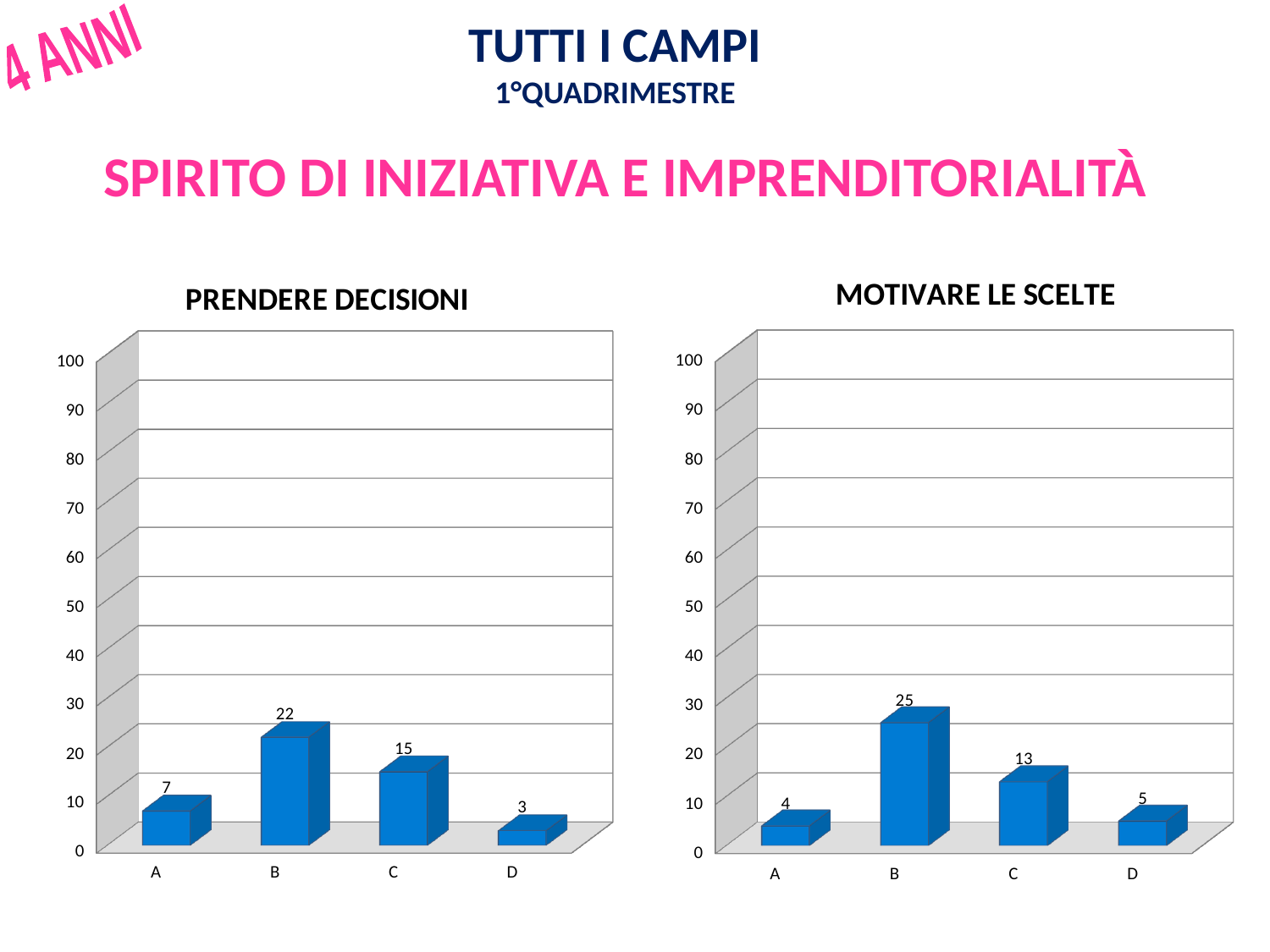
What kind of chart is the PRENDERE DECISIONI chart? bar chart In the MOTIVARE LE SCELTE chart, which category has the lowest value? A In the PRENDERE DECISIONI chart, what is the difference between the values for B and C? 7 In the PRENDERE DECISIONI chart, which category has the highest value? B In the MOTIVARE LE SCELTE chart, what is the value for C? 13 In the PRENDERE DECISIONI chart, what is the value for B? 22 In the MOTIVARE LE SCELTE chart, which is larger, the value for A or the value for D? D In the PRENDERE DECISIONI chart, is the value for B greater or less than 30? less In the PRENDERE DECISIONI chart, what is the value for D? 3 How many categories are shown in the MOTIVARE LE SCELTE chart? 4 In the MOTIVARE LE SCELTE chart, what is the value for A? 4 In the MOTIVARE LE SCELTE chart, what is the difference between the values for B and D? 20